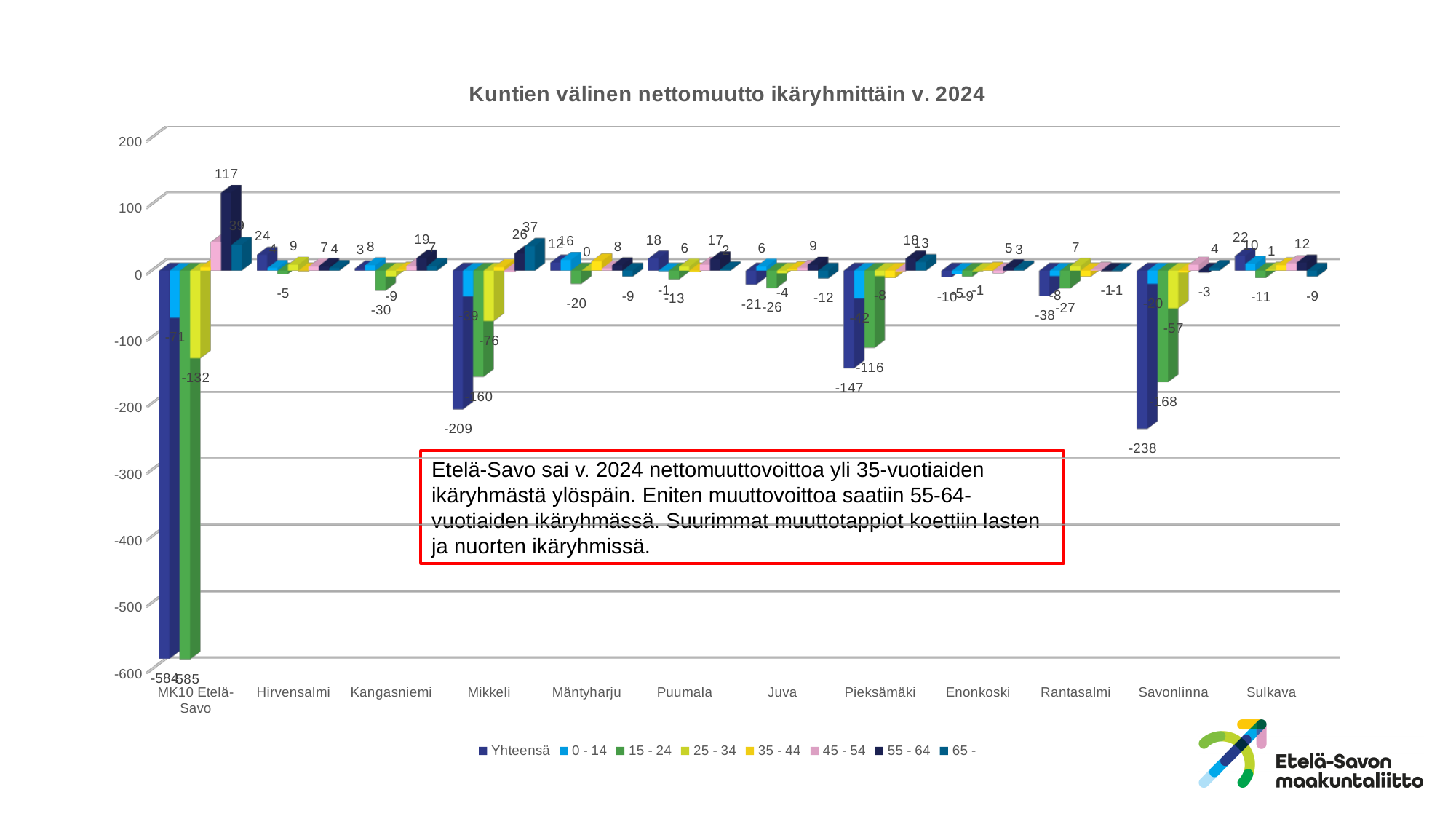
What is the Yhteensä value for Savonlinna? -238 Is the Yhteensä value for Pieksämäki greater or less than -100? less How many series does the legend list? 8 What is the difference between the Yhteensä values of Mikkeli and Savonlinna? 29 What is the 55 - 64 value for MK10 Etelä-Savo? 117 What is the title of the chart? Kuntien välinen nettomuutto ikäryhmittäin v. 2024 How many municipalities/categories are shown on the x axis? 12 What kind of chart is shown on the slide? bar chart What is the Yhteensä value for Mikkeli? -209 What is the 15 - 24 value for Kangasniemi? -30 Which category has the highest 55 - 64 value? MK10 Etelä-Savo Which category has the lowest Yhteensä value? MK10 Etelä-Savo